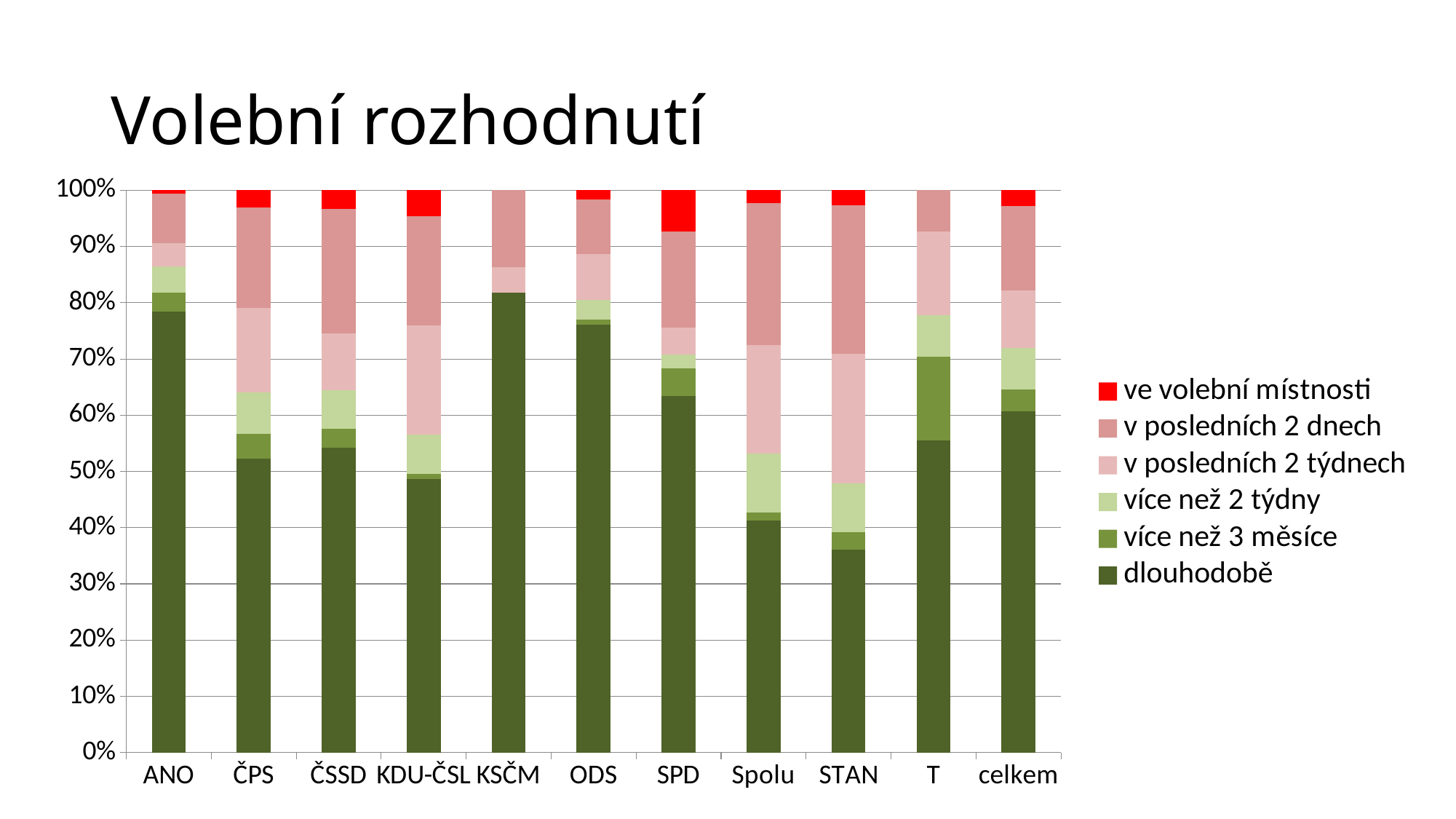
What kind of chart is shown on the slide? Stacked bar chart Is the 'dlouhodobě' share for T greater or less than 50%? greater Which has a larger 'dlouhodobě' share, ODS or ČPS? ODS How many categories are shown along the x axis of the chart? 11 Is the 'dlouhodobě' share for STAN greater or less than 40%? less Is the 'dlouhodobě' share for ANO greater or less than 70%? greater Which category has the highest share for 'dlouhodobě'? KSČM What is the title of the slide? Volební rozhodnutí Which category has the lowest share for 'dlouhodobě'? STAN Which legend entry is shown in red? ve volební místnosti Which category has the largest 've volební místnosti' segment? SPD How many series does the legend of the chart list? 6